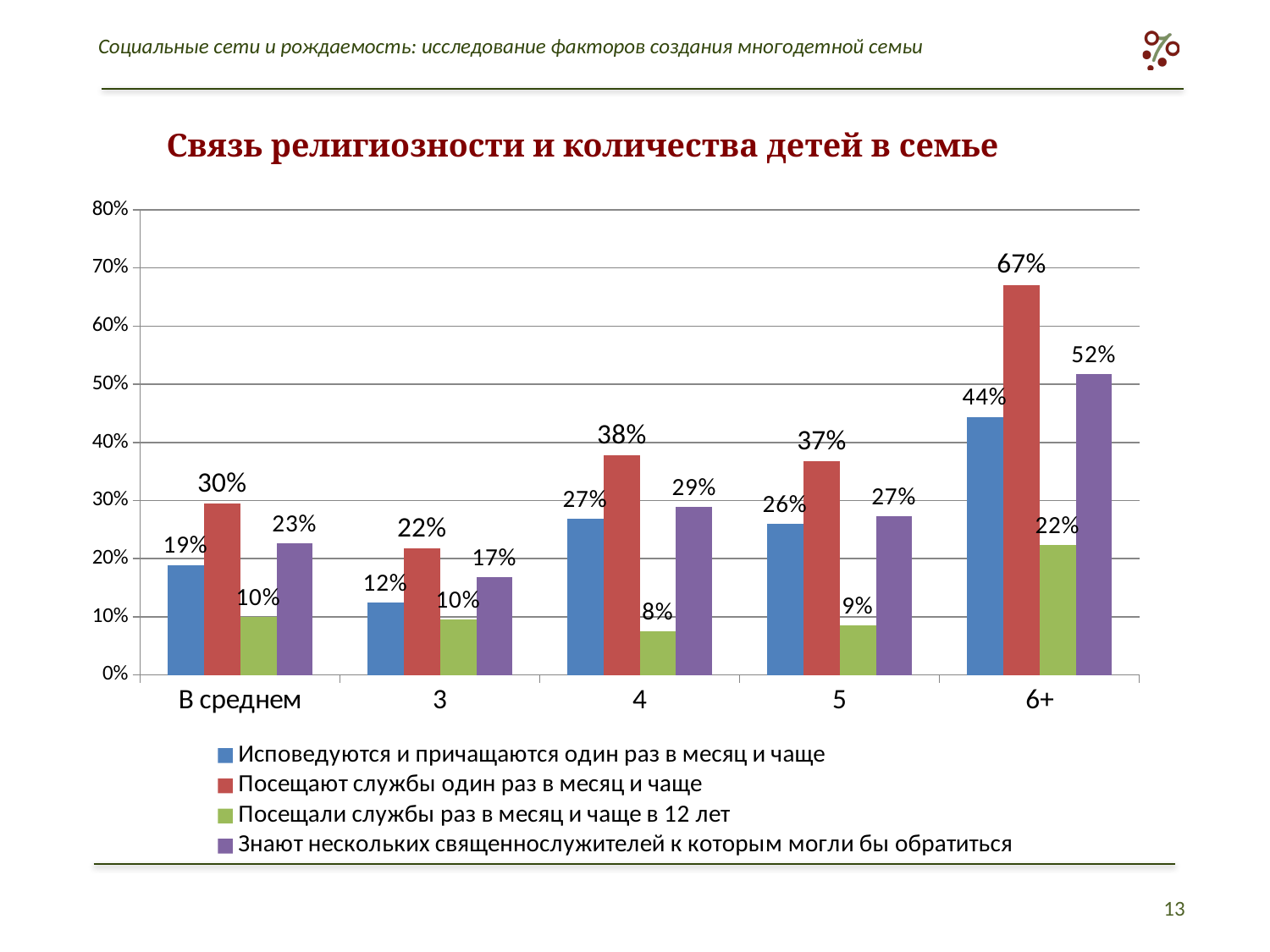
What is the title of the chart? Связь религиозности и количества детей в семье What is the value for "Исповедуются и причащаются один раз в месяц и чаще" in the "В среднем" category? 19% Which is larger in the "4" category: "Исповедуются и причащаются один раз в месяц и чаще" or "Знают нескольких священнослужителей к которым могли бы обратиться"? Знают нескольких священнослужителей к которым могли бы обратиться Which category has the lowest value for "Исповедуются и причащаются один раз в месяц и чаще"? 3 How many series does the legend list? 4 What is the value for "Знают нескольких священнослужителей к которым могли бы обратиться" in the "3" category? 17% What is the value for "Посещали службы раз в месяц и чаще в 12 лет" in the "4" category? 8% What is the value for "Посещают службы один раз в месяц и чаще" in the "6+" category? 67% What kind of chart is shown on the slide? Bar chart How many categories are shown on the x axis? 5 What is the difference between the "Посещают службы один раз в месяц и чаще" values for "6+" and "5"? 30% Which category has the highest value for "Посещают службы один раз в месяц и чаще"? 6+